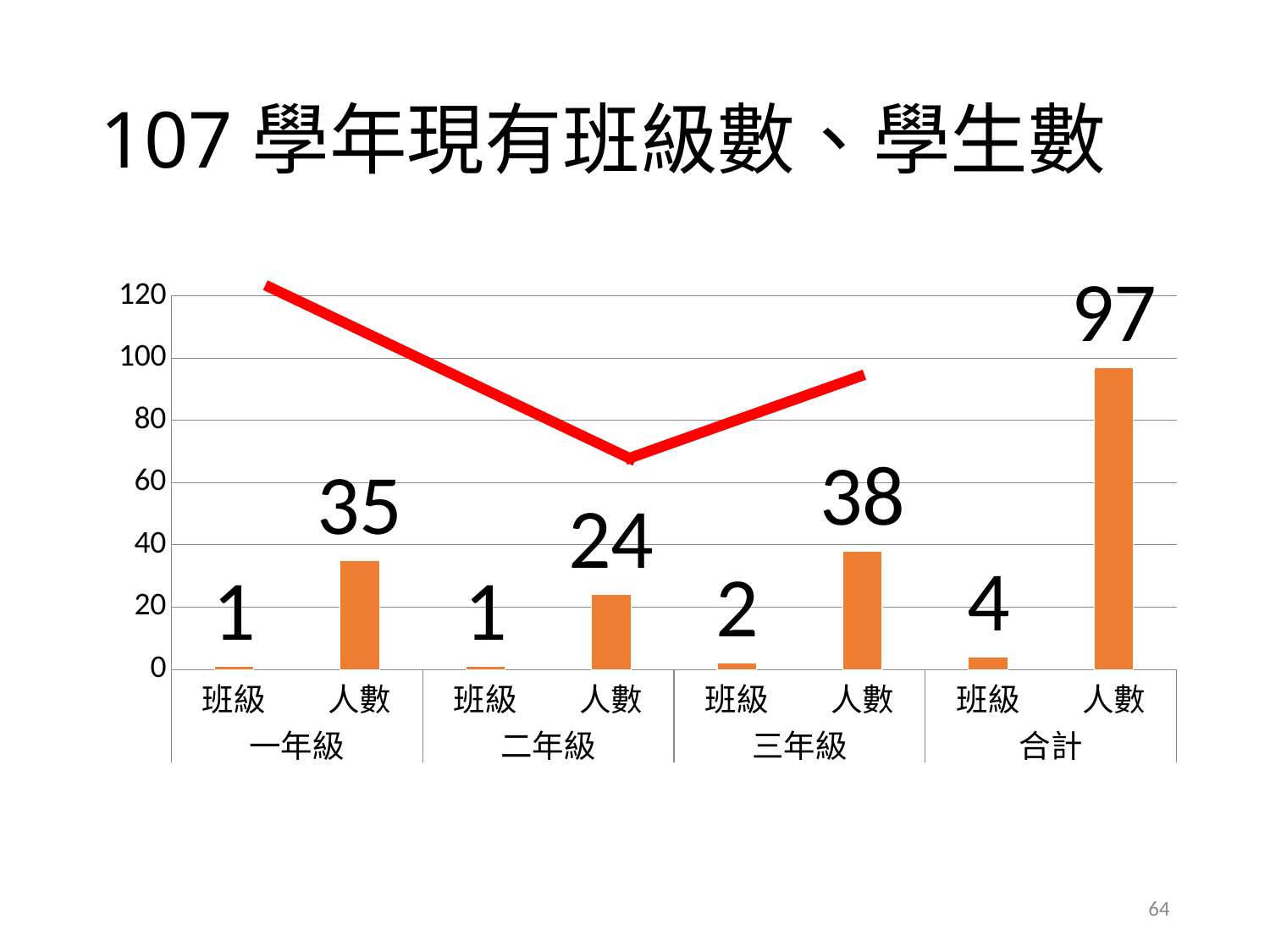
What kind of chart is shown on the slide? Bar chart What is the 人數 value for 二年級? 24 What is the title of the slide? 107 學年現有班級數、學生數 Which is larger, the 人數 for 一年級 or the 人數 for 二年級? 一年級 Which grade (一年級, 二年級 or 三年級) has the highest 人數? 三年級 What is the 班級 value for 三年級? 2 What is the 人數 value for 合計? 97 What is the difference between the 人數 of 三年級 and the 人數 of 二年級? 14 What is the 人數 value for 一年級? 35 Which grade (一年級, 二年級 or 三年級) has the lowest 人數? 二年級 How many bars are plotted in the chart? 8 What is the 班級 value for 合計? 4